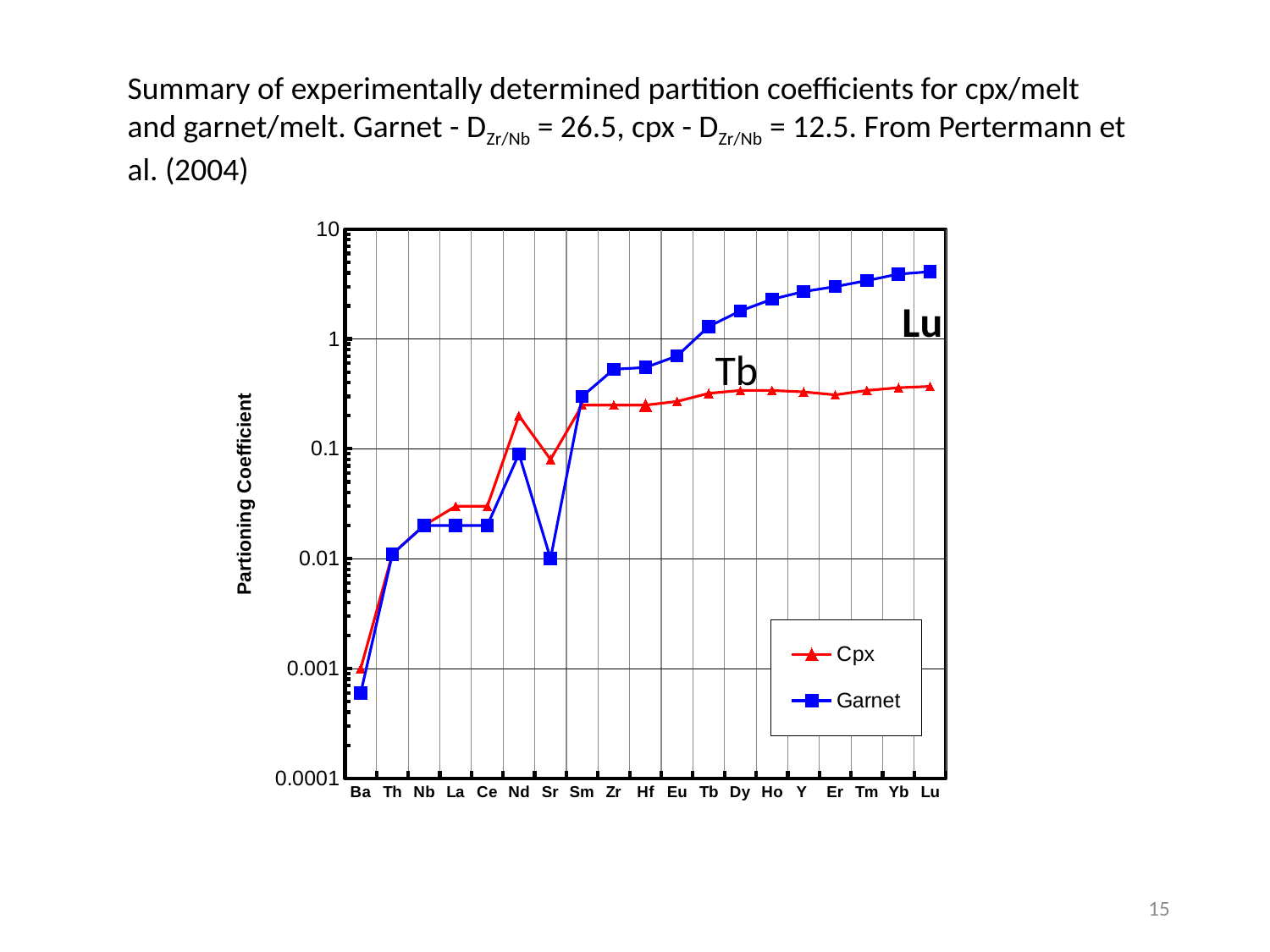
What is the title of the y axis? Partioning Coefficient Which series has the larger value at Nd, Cpx or Garnet? Cpx At which element does the Garnet series have its highest value? Lu What kind of chart is shown on the slide? line chart Which series reaches the highest partitioning coefficient on the chart? Garnet Is the Garnet value for Ba greater or less than 0.001? less How many series does the legend list? 2 Is the Cpx value for Lu greater or less than 1? less Does the Garnet series rise or fall from Sm to Lu along the x axis? rise Is the Garnet value for Lu greater or less than 1? greater At which element does the Garnet series have its lowest value? Ba How many elements are labelled along the x axis? 19